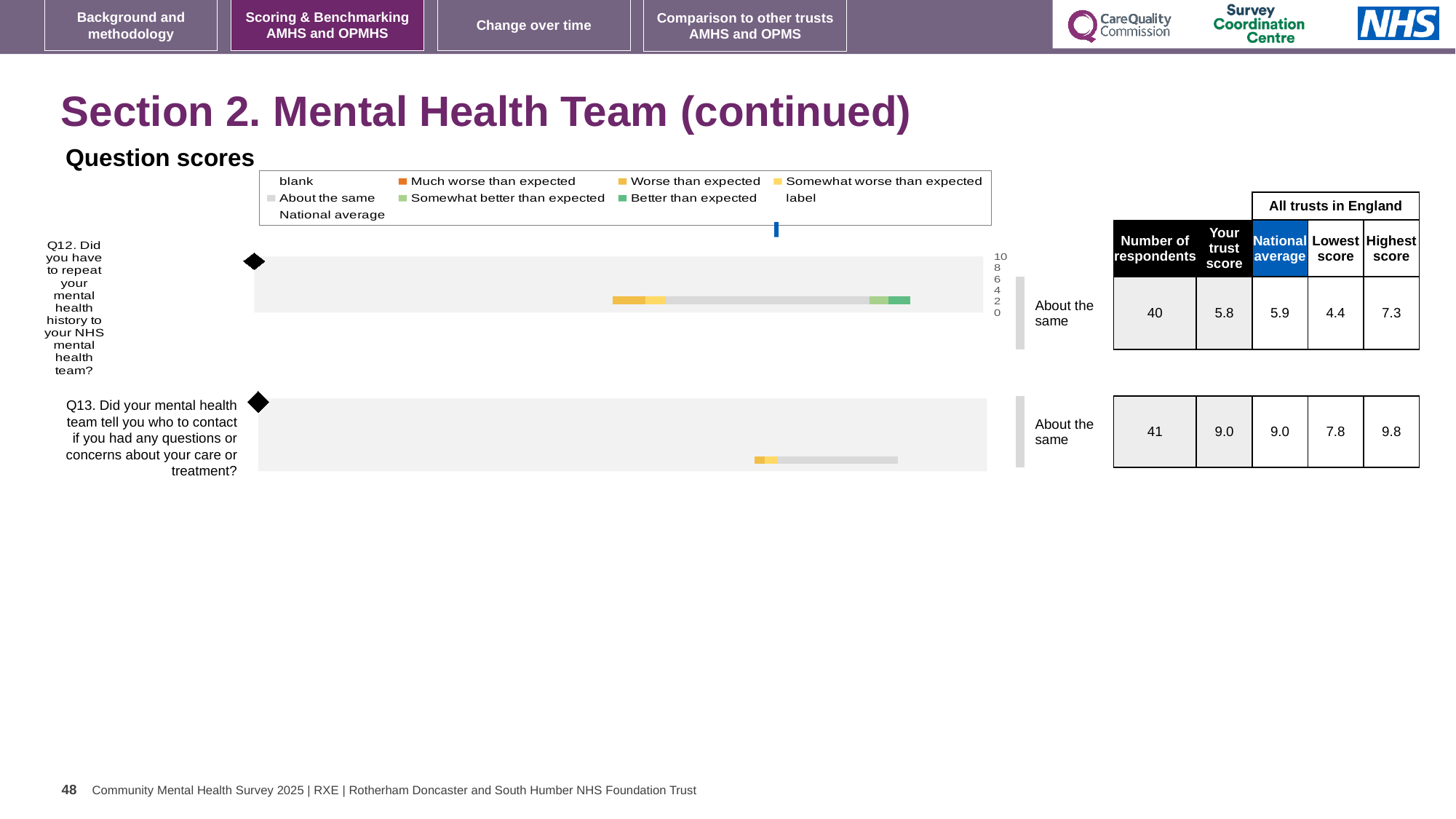
What is the difference between the highest score and the lowest score for Q12 across all trusts in England? 2.9 How many questions (categories) are plotted in the question scores charts? 2 What is the national average for Q12? 5.9 Which legend entry is shown in dark green? Better than expected What is the trust score for Q13 (told who to contact with questions or concerns)? 9.0 What is the trust score for Q12 (repeating mental health history)? 5.8 What is the difference between the highest score and the lowest score for Q13 across all trusts in England? 2.0 What is the benchmark category shown next to the bar for Q13? About the same How many respondents answered Q13? 41 Which question has the higher trust score, Q12 or Q13? Q13 What is the benchmark category shown next to the bar for Q12? About the same What kind of chart is used to show the question scores for Q12 and Q13? bar chart